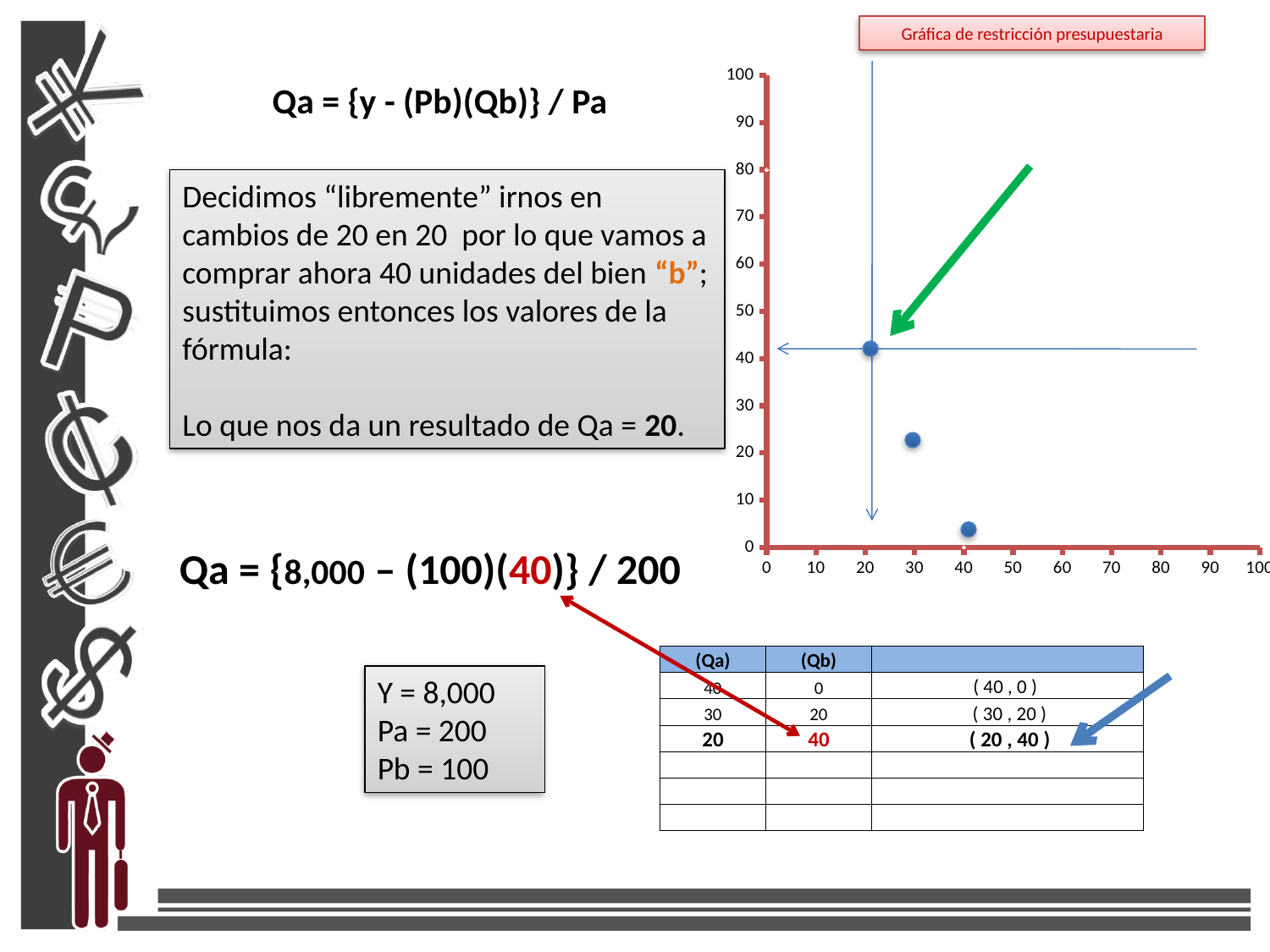
Which plotted point has the highest y value: the one near x = 20, x = 30, or x = 40? The one near x = 20 Is the y value of the point plotted near x = 30 greater or less than 10? greater Is the y value of the point plotted near x = 30 greater or less than 30? less What kind of chart is shown on the slide? Scatter chart Is the y value of the point plotted near x = 20 greater or less than 30? greater What is the highest value shown on the chart's vertical axis? 100 Do the plotted points rise or fall as the x value increases? Fall Which has the larger y value: the point near x = 20 or the point near x = 40? The point near x = 20 What is the title of the chart? Gráfica de restricción presupuestaria Which plotted point has the lowest y value: the one near x = 20, x = 30, or x = 40? The one near x = 40